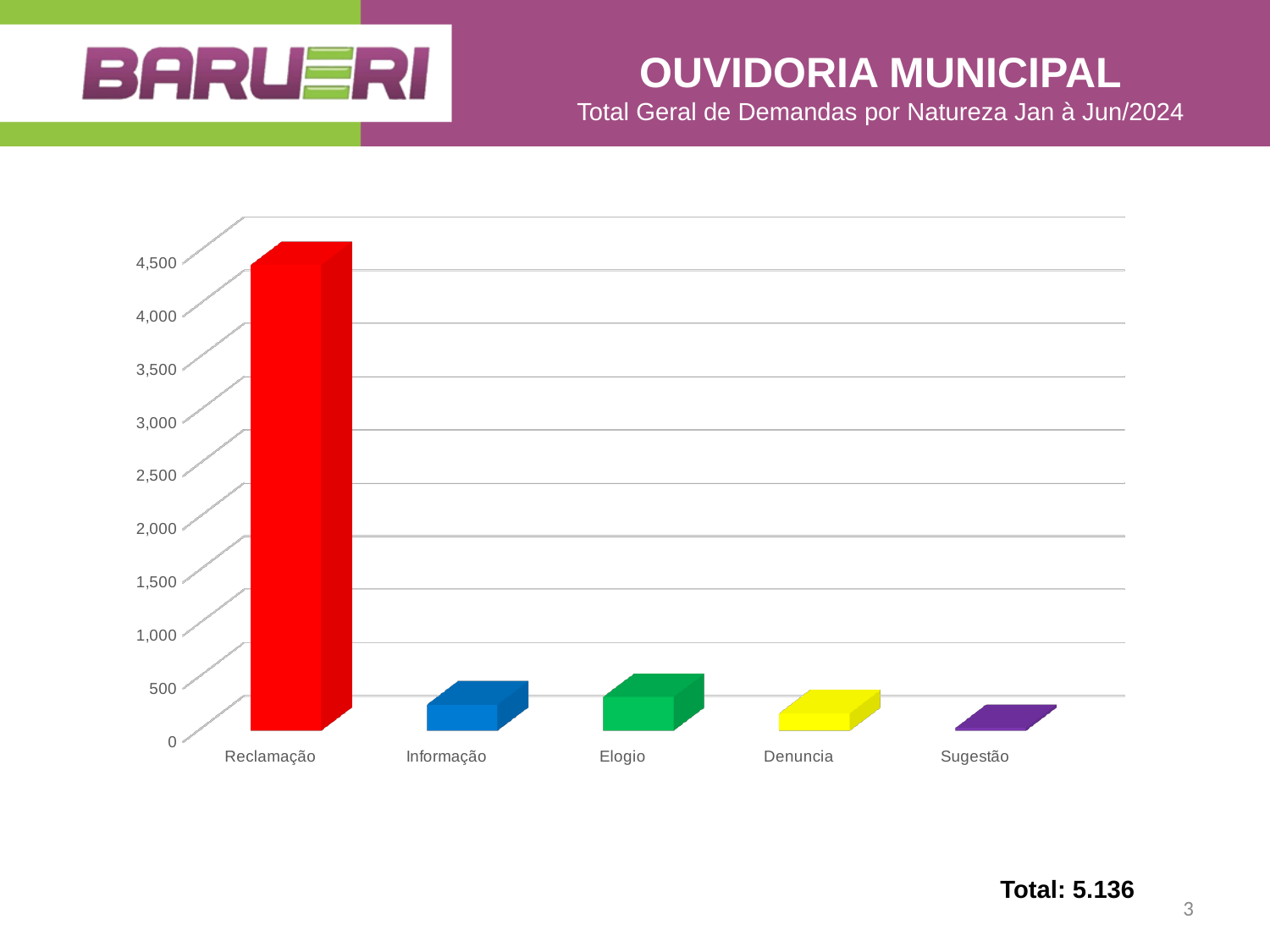
How many categories are shown on the x axis of the chart? 5 Is the value for Informação greater or less than 500? less Is the value for Sugestão greater or less than 500? less Is the value for Elogio greater or less than 500? less What colour is the bar for Reclamação? red What kind of chart is shown on the slide? bar chart What is the subtitle of the chart shown on the slide? Total Geral de Demandas por Natureza Jan à Jun/2024 Which is larger, the value for Denuncia or the value for Sugestão? Denuncia Which category has the highest value in the chart? Reclamação Which category has the lowest value in the chart? Sugestão Which is larger, the value for Reclamação or the value for Informação? Reclamação